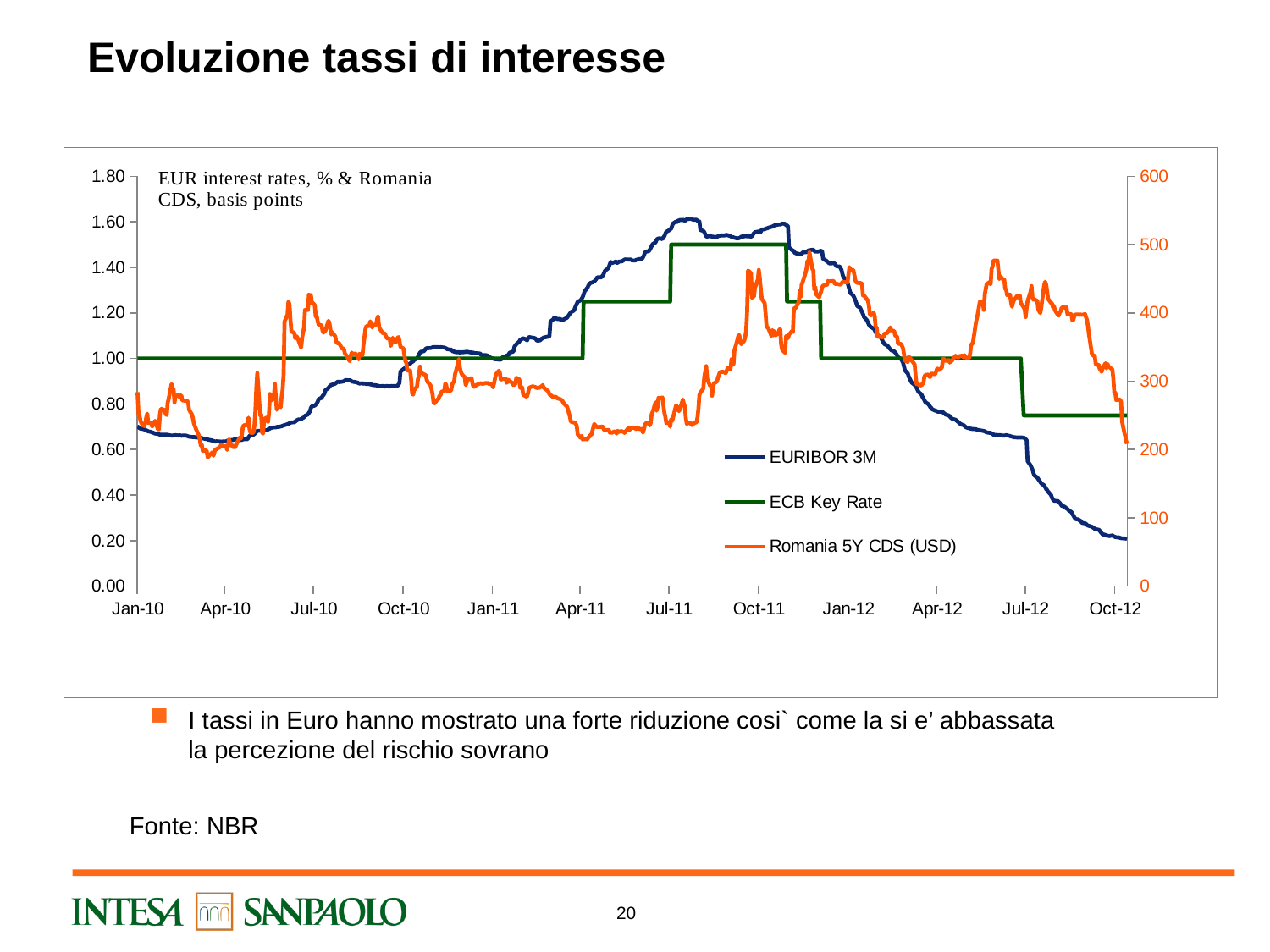
Is the Romania 5Y CDS (USD) value at Oct-12 greater or less than 300? less How many date labels are shown on the x axis? 12 Is the EURIBOR 3M value at Oct-12 greater or less than 0.40? less Is the EURIBOR 3M value at Jul-11 greater or less than 1.40? greater At Oct-12, which is higher: EURIBOR 3M or the ECB Key Rate? ECB Key Rate How many series does the chart legend list? 3 Does the EURIBOR 3M line rise or fall between Jan-12 and Oct-12? fall What is the ECB Key Rate at Jan-10? 1.00 Which series is drawn in orange? Romania 5Y CDS (USD) What kind of chart is shown on the slide? line chart At Jan-10, which is higher: EURIBOR 3M or the ECB Key Rate? ECB Key Rate